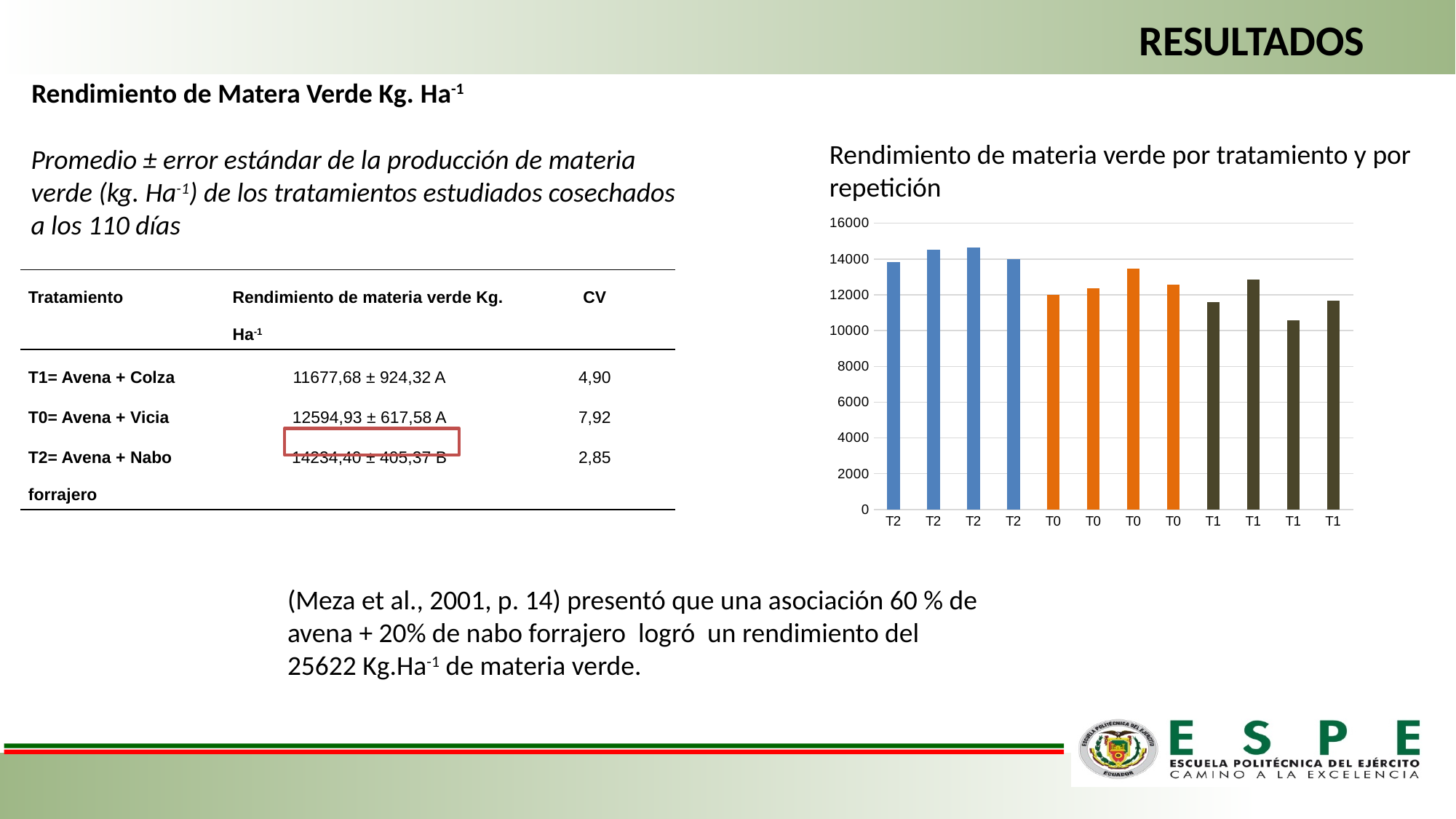
Which treatment label has the highest bar in the chart? T2 Is the value of the third T2 bar greater or less than 14000? greater What is the title of the chart on the slide? Rendimiento de materia verde por tratamiento y por repetición Is the value of the third T1 bar greater or less than 12000? less What kind of chart is shown on the slide? bar chart Which is larger, the first T2 bar or the first T0 bar? the first T2 bar Which treatment label has the lowest bar in the chart? T1 Which is larger, the third T0 bar or the first T1 bar? the third T0 bar How many bars are labelled T0 in the chart? 4 Is the value of the third T0 bar greater or less than 12000? greater What is the maximum value shown on the vertical axis of the chart? 16000 How many bars are plotted in the chart? 12